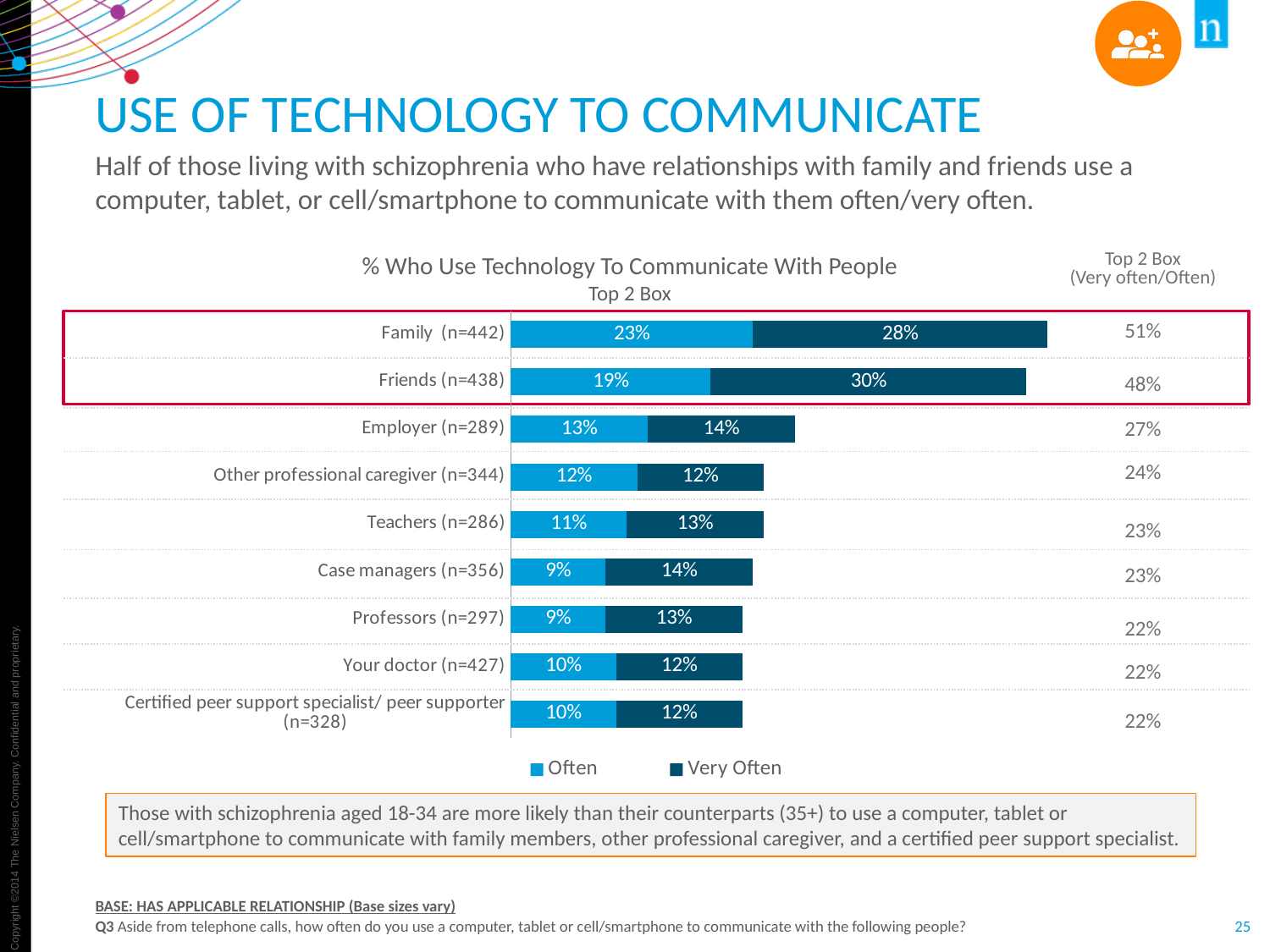
What kind of chart is shown on the slide? Stacked bar chart How many categories (relationship types) are plotted in the chart? 9 What is the Top 2 Box total for Other professional caregiver (n=344)? 24% What are the two series named in the legend? Often and Very Often What is the difference between the 'Very Often' values for Friends (n=438) and Family (n=442)? 2% Which category has the highest Top 2 Box (Very often/Often) total? Family (n=442) What is the 'Often' value for Family (n=442)? 23% Which is larger: the 'Often' value for Family (n=442) or the 'Often' value for Friends (n=438)? Family (n=442) How many series does the legend list? 2 What is the 'Very Often' value for Employer (n=289)? 14% What is the 'Very Often' value for Friends (n=438)? 30% Which category has the lowest 'Often' value? Case managers (n=356) and Professors (n=297), both 9%